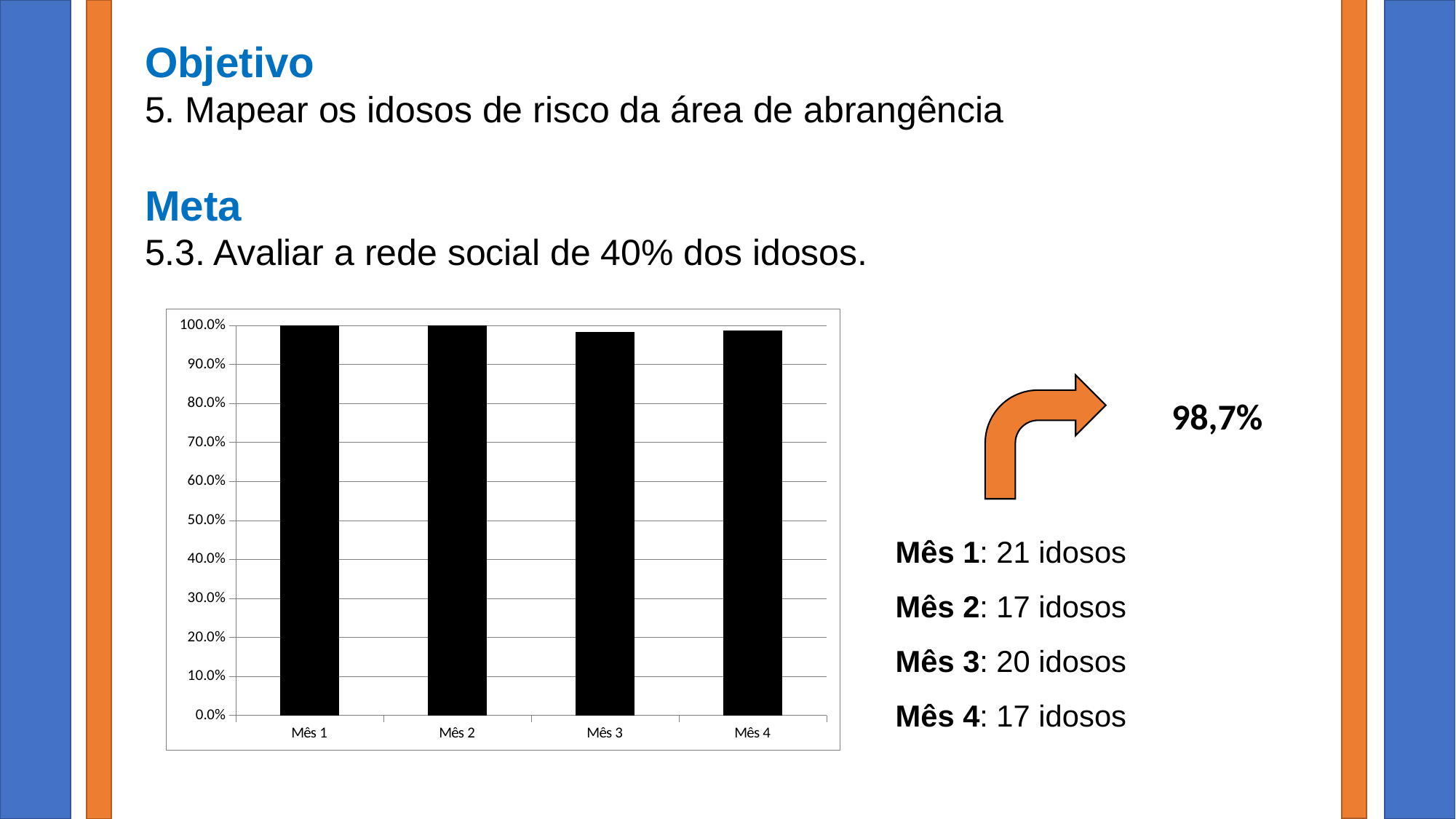
How many categories are plotted on the x axis of the chart? 4 Which is larger, the value for Mês 2 or the value for Mês 3? Mês 2 Is the value for Mês 3 greater or less than 90.0%? greater Is the value for Mês 4 greater or less than 90.0%? greater What colour are the bars in the chart? black What is the label of the first category on the x axis? Mês 1 Is the value for Mês 1 greater or less than 50.0%? greater What is the value for Mês 2 in the chart? 100.0% What kind of chart is shown on the slide? bar chart What is the value for Mês 1 in the chart? 100.0%